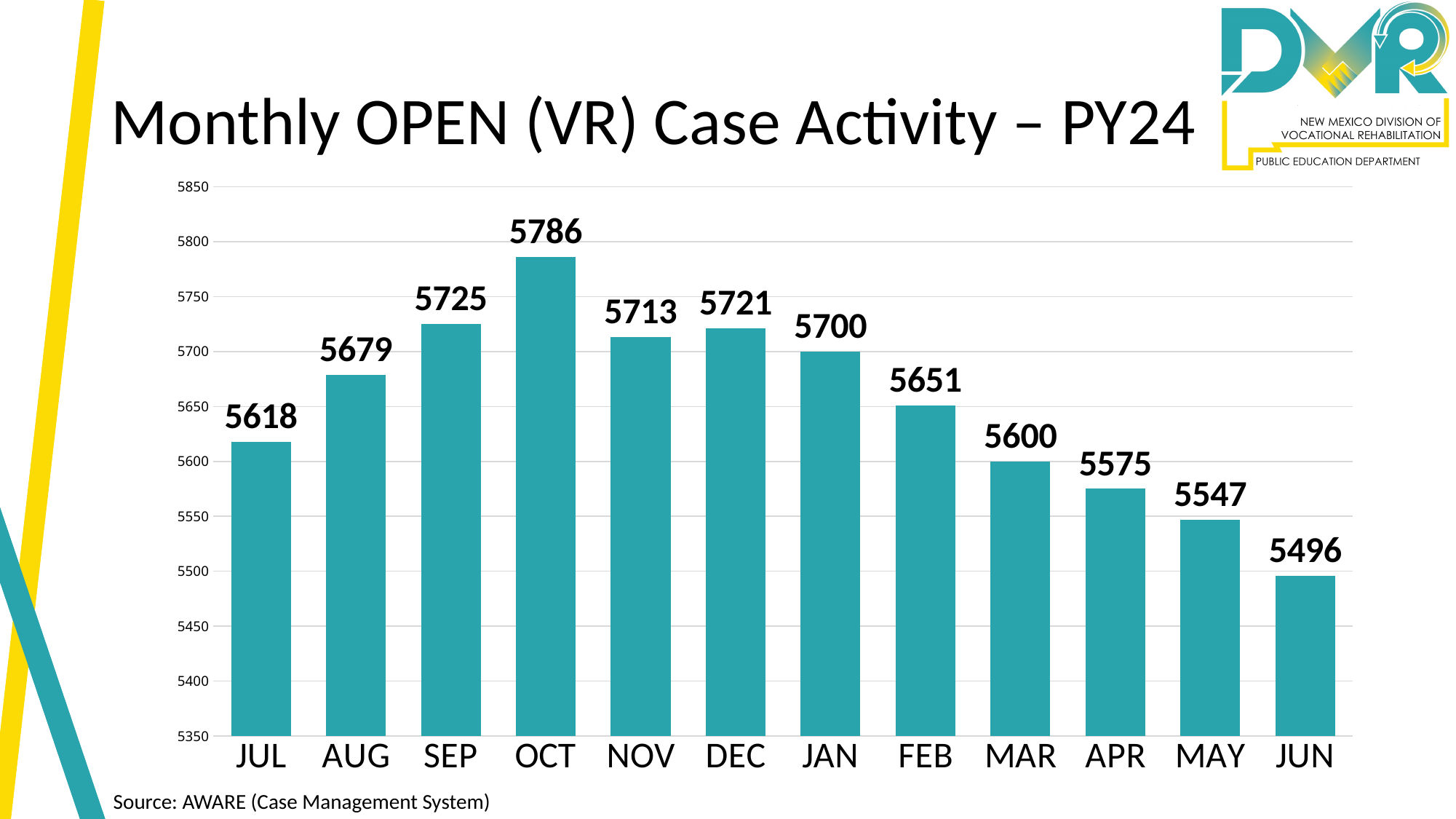
What is the value for FEB? 5651 What is the value for JUN? 5496 What kind of chart is shown on the slide? bar chart What is the value for OCT? 5786 What is the difference between the values for OCT and JUN? 290 How many months are shown on the x axis? 12 What is the difference between the values for JUL and AUG? 61 Do the values rise or fall from OCT to JUN? fall Which is larger, the value for NOV or the value for DEC? DEC Which month has the highest value? OCT Is the value for MAR greater or less than 5650? less Which month has the lowest value? JUN